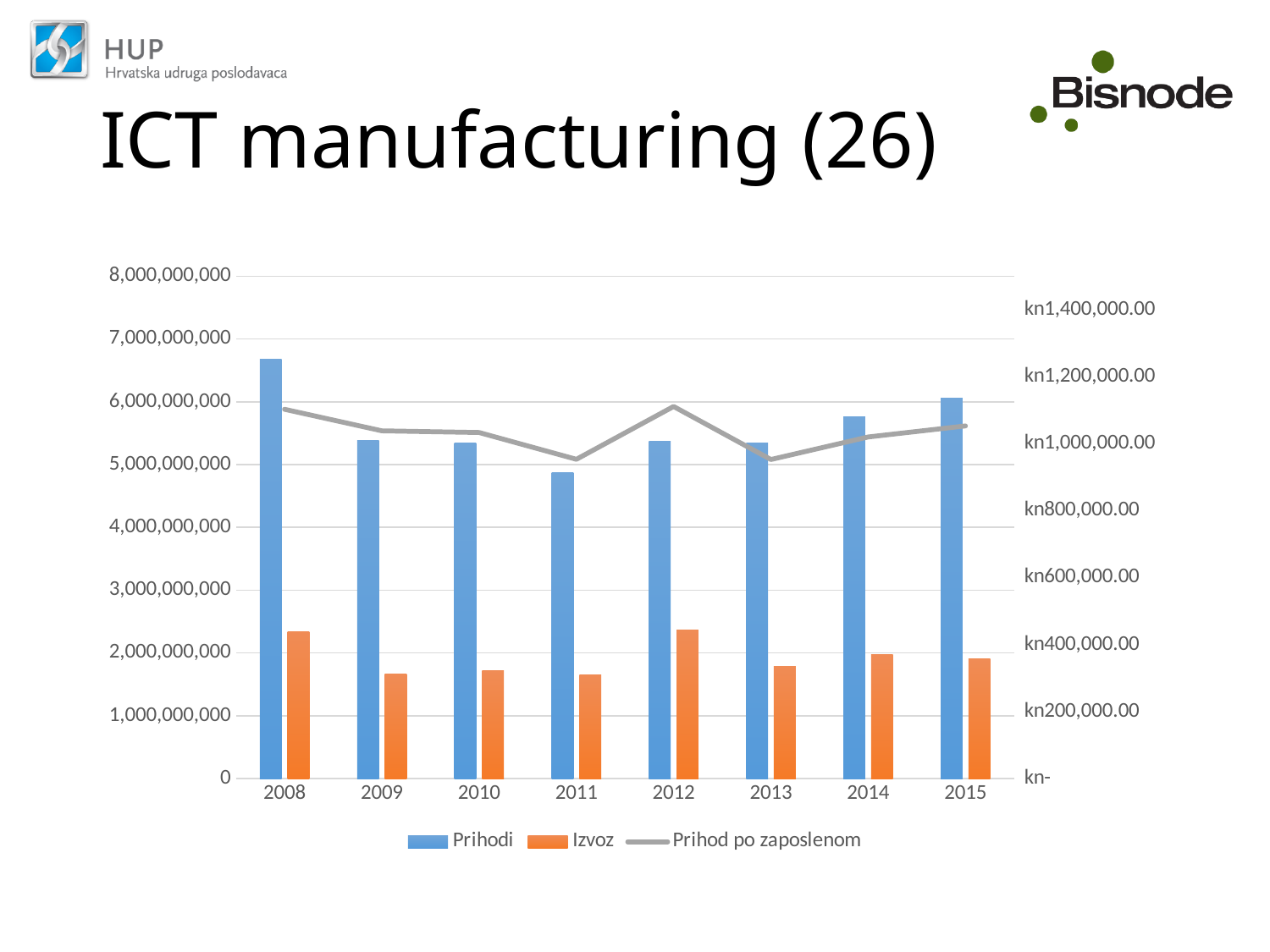
Is the Prihod po zaposlenom value for 2011 greater or less than kn1,000,000.00? less Which series is drawn as a line in the chart? Prihod po zaposlenom Is the Izvoz value for 2010 greater or less than 2,000,000,000? less Is the Izvoz value for 2012 greater or less than 2,000,000,000? greater Which year has the larger Prihodi value, 2013 or 2014? 2014 In which year is the Prihodi bar the lowest? 2011 In which year is the Prihodi bar the highest? 2008 How many years are shown on the x axis of the chart? 8 What kind of chart is shown on the slide? A bar chart combined with a line chart How many series does the chart legend list? 3